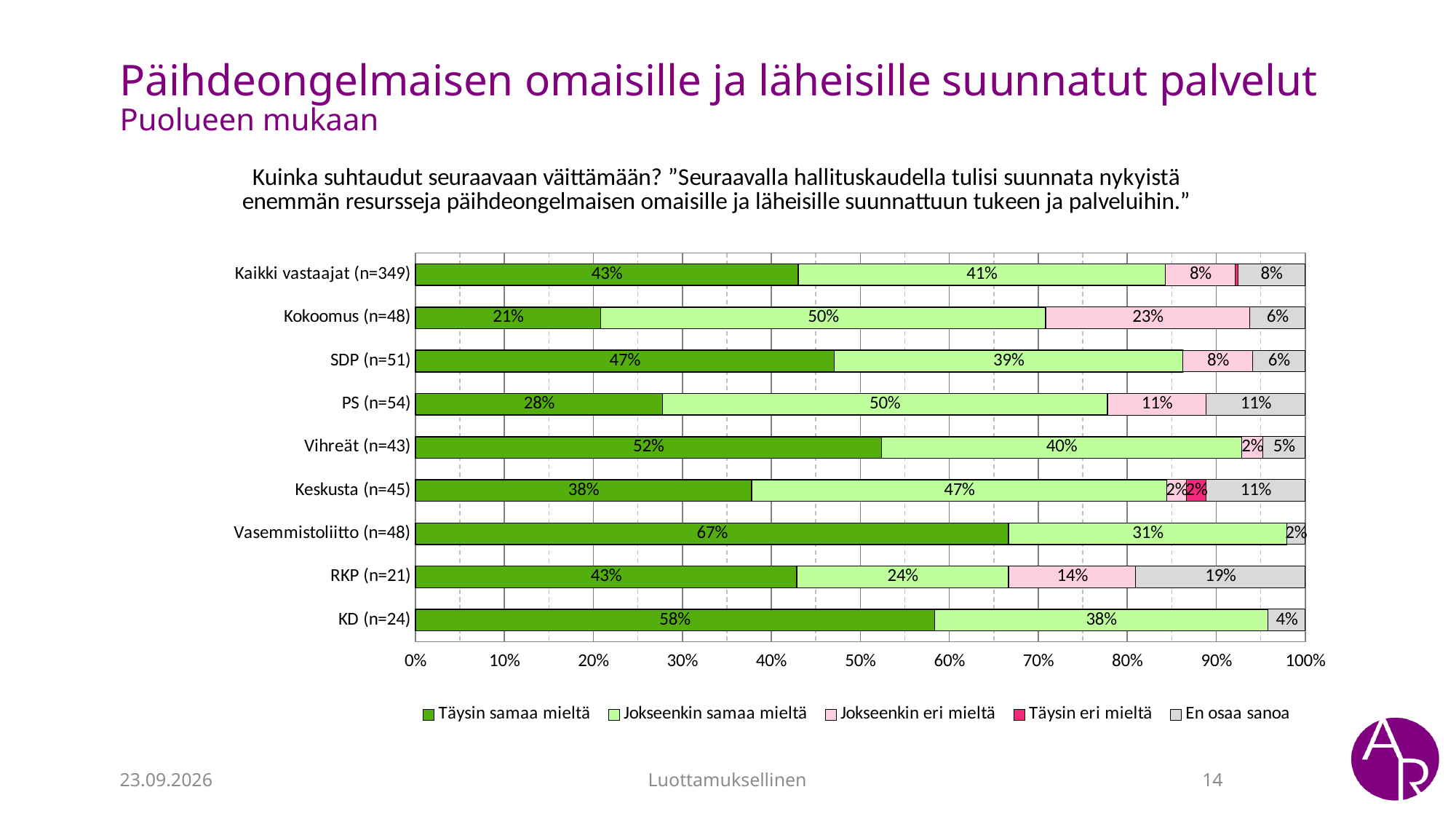
What is the value of "Täysin samaa mieltä" for Vasemmistoliitto (n=48)? 67% Which has a larger "Täysin samaa mieltä" value, KD (n=24) or Vihreät (n=43)? KD (n=24) What is the value of "Jokseenkin eri mieltä" for Kokoomus (n=48)? 23% Which category has the lowest "Täysin samaa mieltä" value? Kokoomus (n=48) What is the value of "Jokseenkin samaa mieltä" for PS (n=54)? 50% How many series does the legend list? 5 How many categories (bars) are shown in the chart? 9 What is the value of "En osaa sanoa" for RKP (n=21)? 19% What is the difference in "Täysin samaa mieltä" between SDP (n=51) and Kokoomus (n=48)? 26 percentage points What kind of chart is shown on the slide? Stacked bar chart Which category has the highest "En osaa sanoa" value? RKP (n=21) Which category has the highest "Täysin samaa mieltä" value? Vasemmistoliitto (n=48)